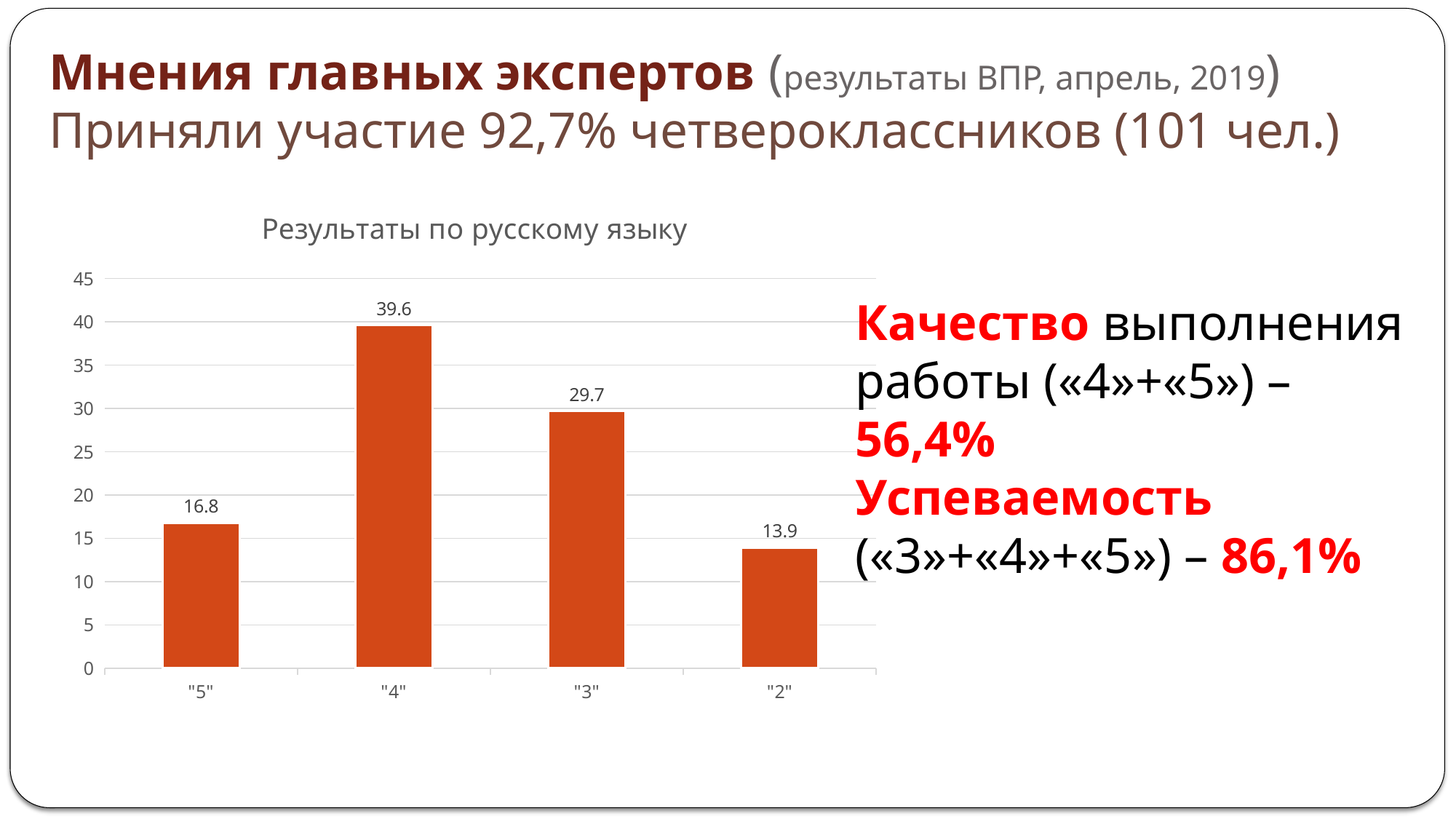
What is the difference between the values for "4" and "3"? 9.9 Which category has the highest value? "4" What kind of chart is shown on the slide? bar chart Which category has the lowest value? "2" What is the value for "2" in the chart? 13.9 What is the title of the chart? Результаты по русскому языку How many categories are shown on the x axis? 4 What is the difference between the values for "5" and "2"? 2.9 Which is larger, the value for "5" or the value for "2"? "5" What is the value for "5" in the chart? 16.8 Is the value for "3" greater or less than 25? greater What is the value for "4" in the chart? 39.6